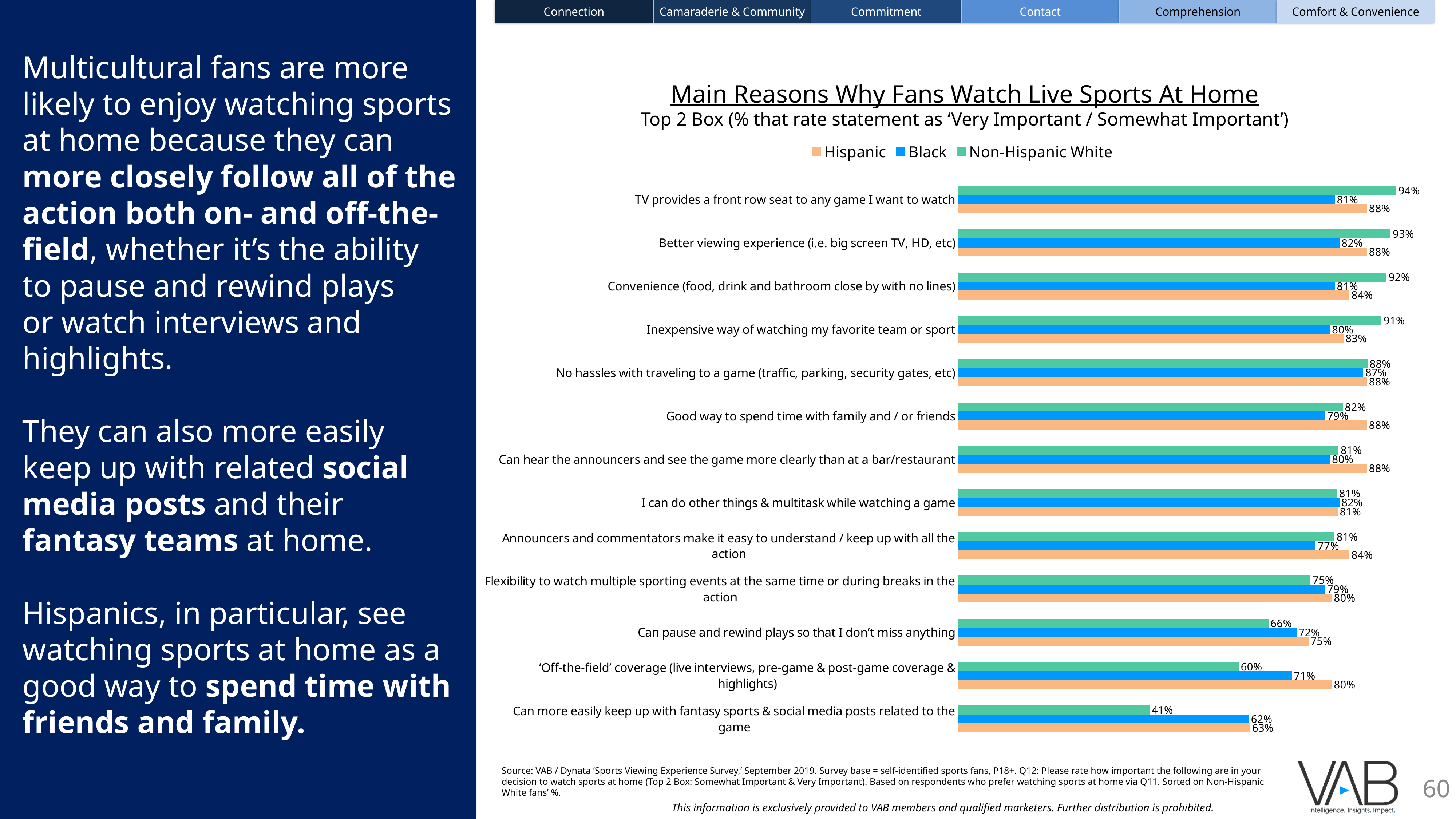
Which series is shown in orange in the legend? Hispanic Which reason has the highest Non-Hispanic White value? TV provides a front row seat to any game I want to watch How many reasons (categories) are plotted in the chart? 13 What is the Non-Hispanic White value for 'TV provides a front row seat to any game I want to watch'? 94% What is the Hispanic value for 'Off-the-field coverage (live interviews, pre-game & post-game coverage & highlights)'? 80% Which reason has the lowest Non-Hispanic White value? Can more easily keep up with fantasy sports & social media posts related to the game What is the difference between the Non-Hispanic White and Black values for 'Convenience (food, drink and bathroom close by with no lines)'? 11% How many series does the legend list? 3 What is the Black value for 'Can pause and rewind plays so that I don't miss anything'? 72% What is the difference between the Hispanic and Non-Hispanic White values for 'Can more easily keep up with fantasy sports & social media posts related to the game'? 22% For 'Good way to spend time with family and / or friends', which is larger: the Hispanic value or the Black value? Hispanic What kind of chart is shown on the slide? Bar chart